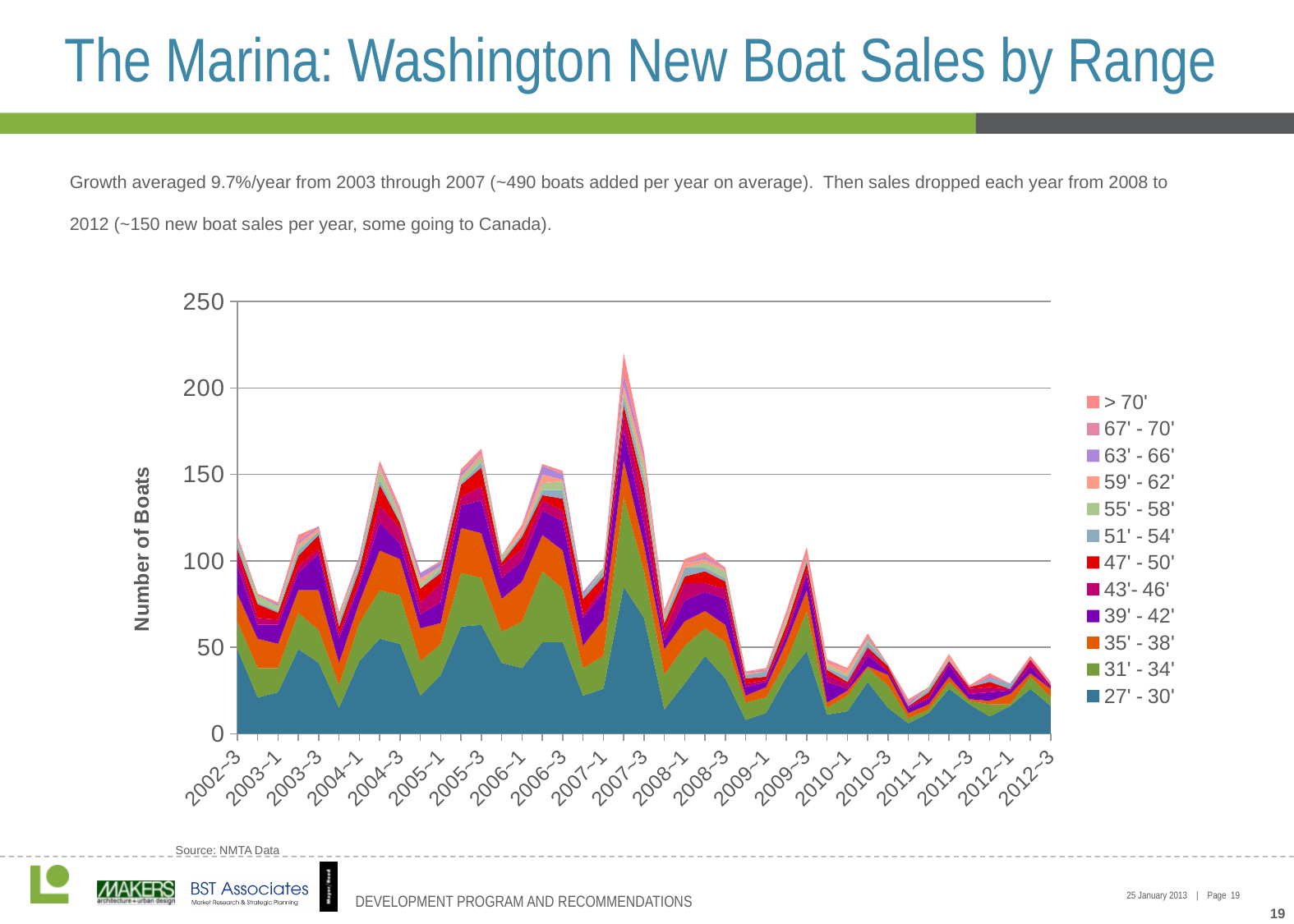
Which boat length range is the bottom (largest, dark blue) series in the chart? 27' - 30' Is the total number of boats in 2007-3 greater or less than 200? less How many period labels are shown along the x axis? 21 Is the total number of boats in 2011-1 greater or less than 50? less Which period has the larger total number of boats, 2007-3 or 2009-3? 2007-3 What kind of chart is shown on the slide? Stacked area chart How many series does the chart's legend list? 12 Is the total number of boats in 2005-3 greater or less than 150? greater What is the label on the chart's vertical axis? Number of Boats Do total boat sales generally rise or fall from 2008-1 to 2012-3? fall